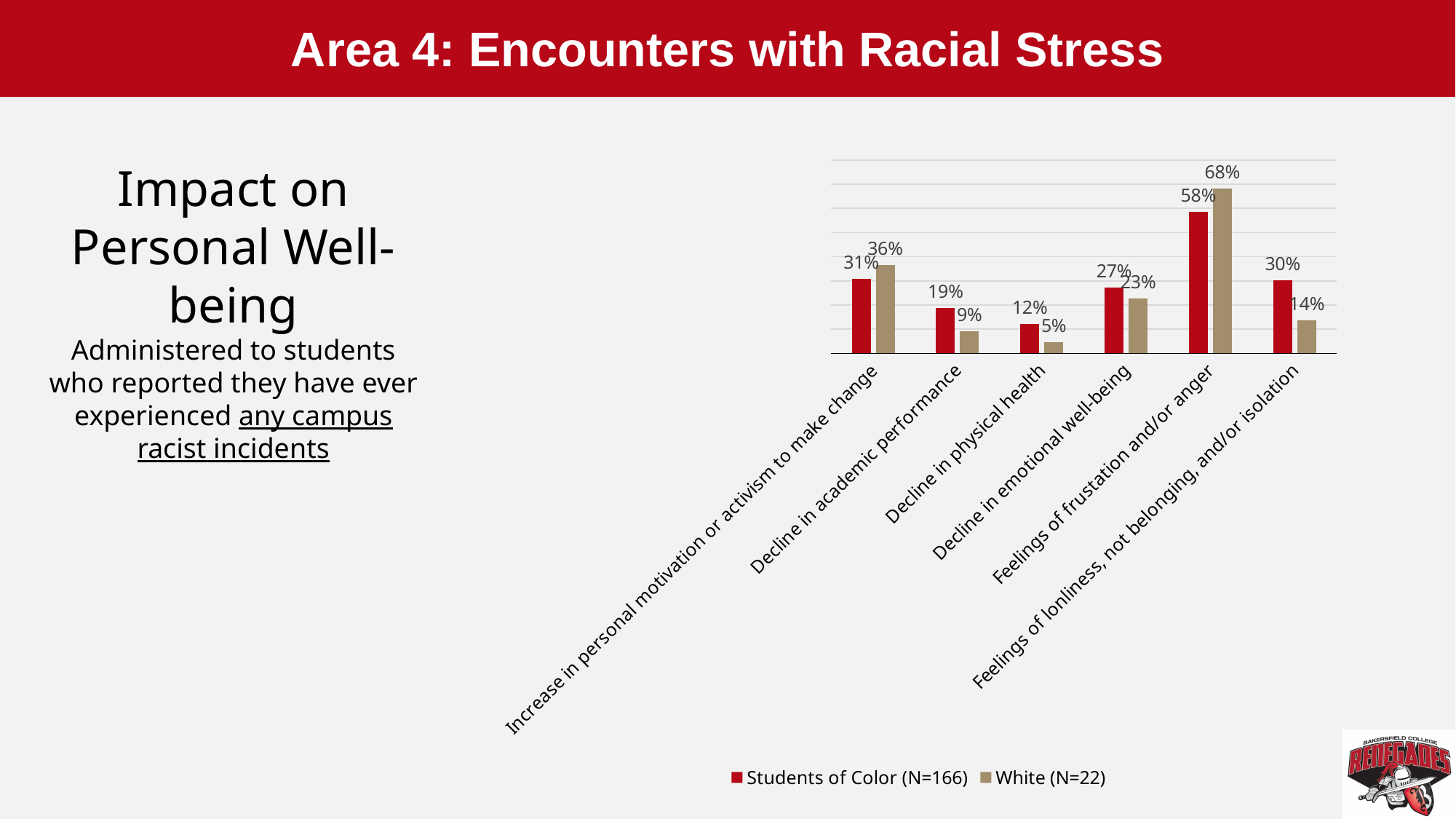
Which category has the lowest value for Students of Color (N=166)? Decline in physical health What is the value for Students of Color (N=166) for 'Feelings of lonliness, not belonging, and/or isolation'? 30% How many series does the chart legend list? 2 What is the difference between the White (N=22) and Students of Color (N=166) values for 'Feelings of frustration and/or anger'? 10% What kind of chart is shown on the slide? Bar chart For 'Increase in personal motivation or activism to make change', which series has the larger value: Students of Color (N=166) or White (N=22)? White (N=22) What is the value for White (N=22) for 'Decline in academic performance'? 9% Which category has the highest value for White (N=22)? Feelings of frustration and/or anger How many categories are shown on the x axis of the chart? 6 What is the difference between the Students of Color (N=166) and White (N=22) values for 'Feelings of lonliness, not belonging, and/or isolation'? 16% What colour are the bars for the Students of Color (N=166) series? Red What is the value for Students of Color (N=166) for 'Feelings of frustration and/or anger'? 58%